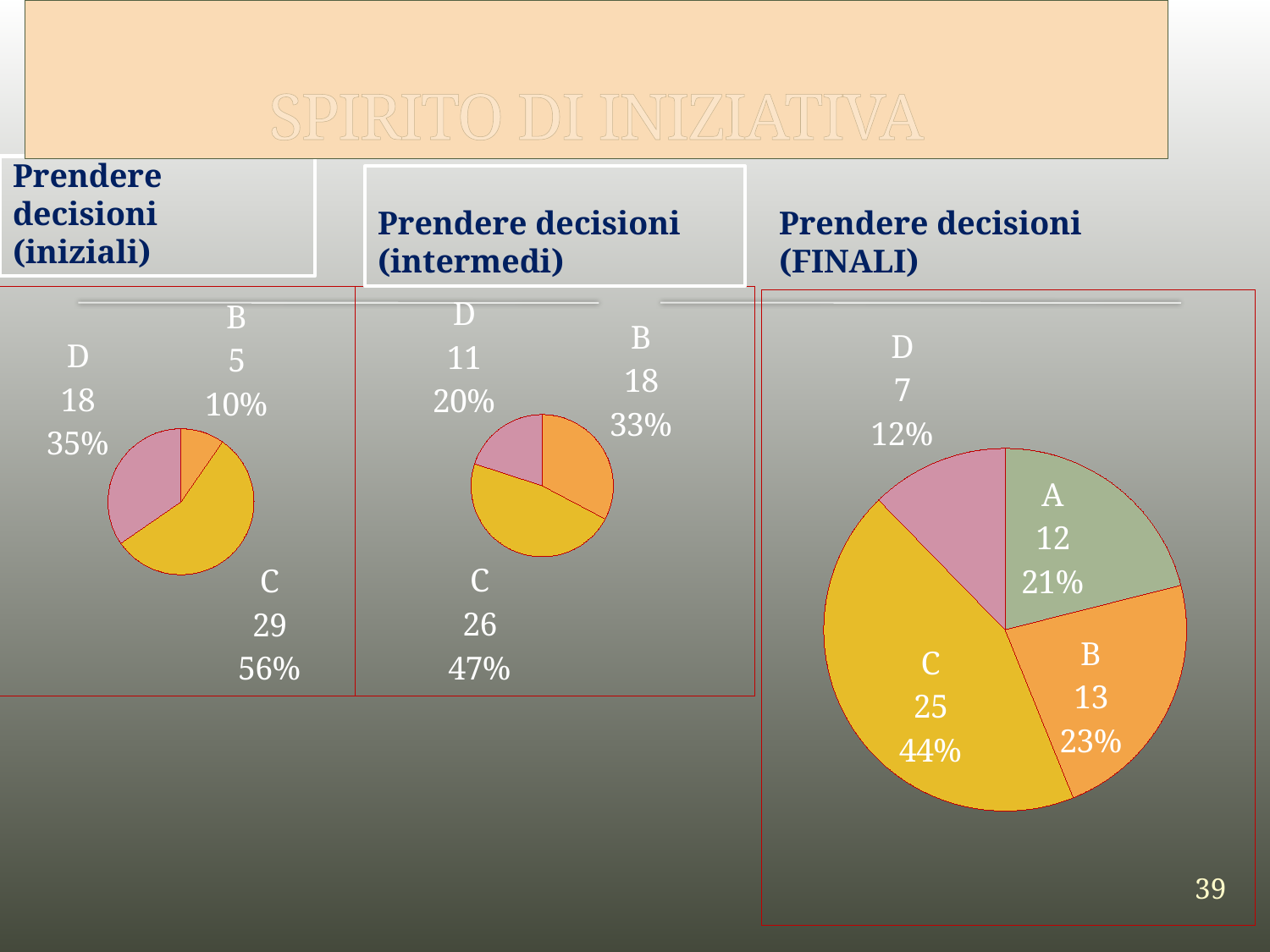
How many categories are shown in the 'Prendere decisioni (FINALI)' chart? 4 In the 'Prendere decisioni (FINALI)' chart, what value is shown for category A? 12 In the 'Prendere decisioni (intermedi)' chart, which category has the largest slice? C What kind of chart is the 'Prendere decisioni (iniziali)' chart? Pie chart In the 'Prendere decisioni (iniziali)' chart, which category has the smallest slice? B In the 'Prendere decisioni (iniziali)' chart, what value is shown for category C? 29 How many charts are shown on the slide? 3 In the 'Prendere decisioni (intermedi)' chart, what value is shown for category B? 18 In the 'Prendere decisioni (FINALI)' chart, what percentage share does category C have? 44% In the 'Prendere decisioni (intermedi)' chart, what is the difference between the values for C and D? 15 In the 'Prendere decisioni (FINALI)' chart, which is larger, the value for B or the value for D? B In the 'Prendere decisioni (iniziali)' chart, what percentage share does category D have? 35%